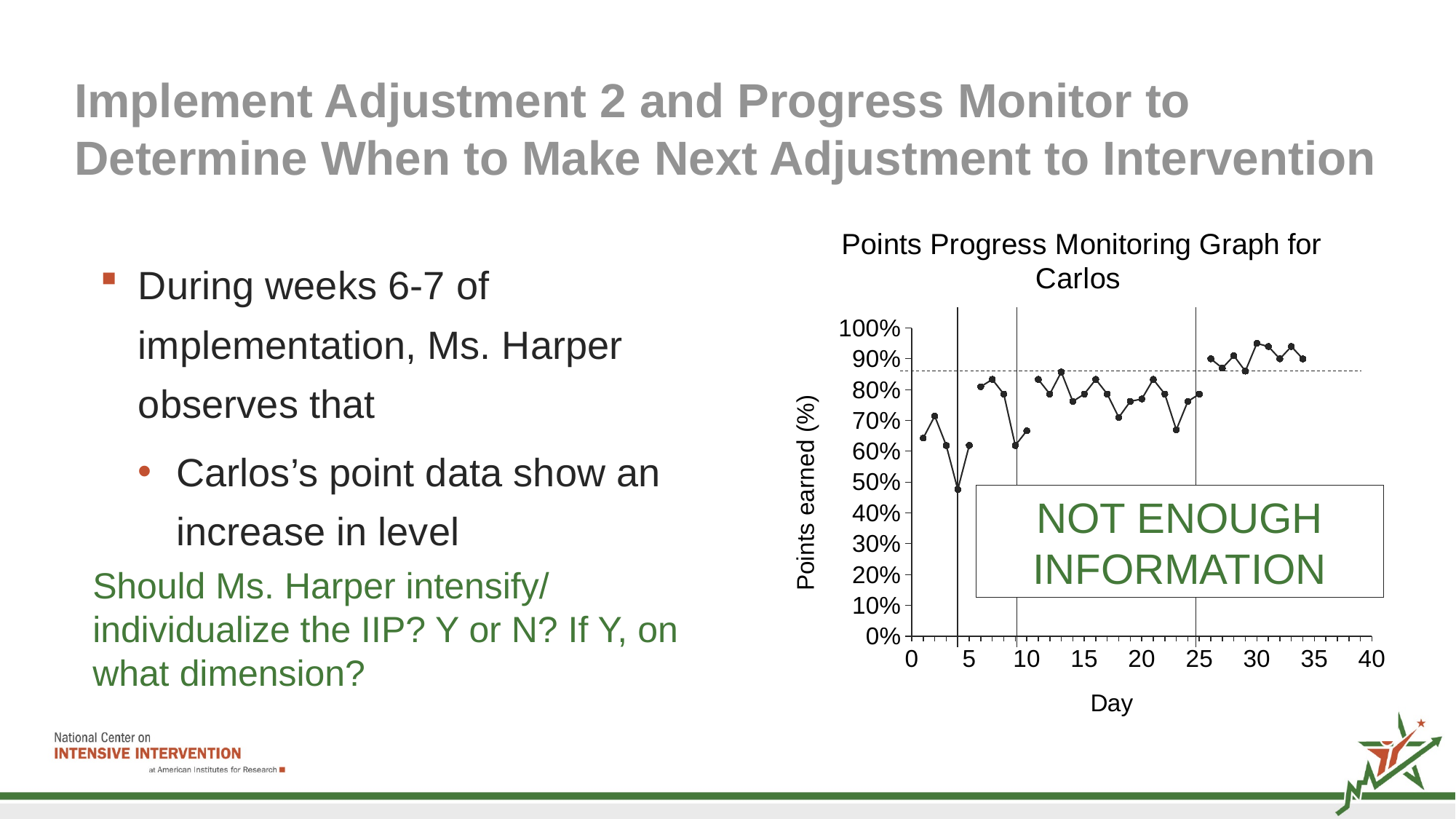
What kind of chart is the Points Progress Monitoring Graph for Carlos? line chart Is the value for Day 23 greater or less than 70%? less Is the value for Day 18 greater or less than 80%? less Is the value for Day 4 greater or less than 60%? less What is the label on the vertical axis of the chart? Points earned (%) On which day is the lowest value of points earned plotted? Day 4 What is the title of the chart on the slide? Points Progress Monitoring Graph for Carlos Do the points earned values generally rise or fall from the first days to the last days on the chart? rise Which is larger, the value for Day 30 or the value for Day 4? Day 30